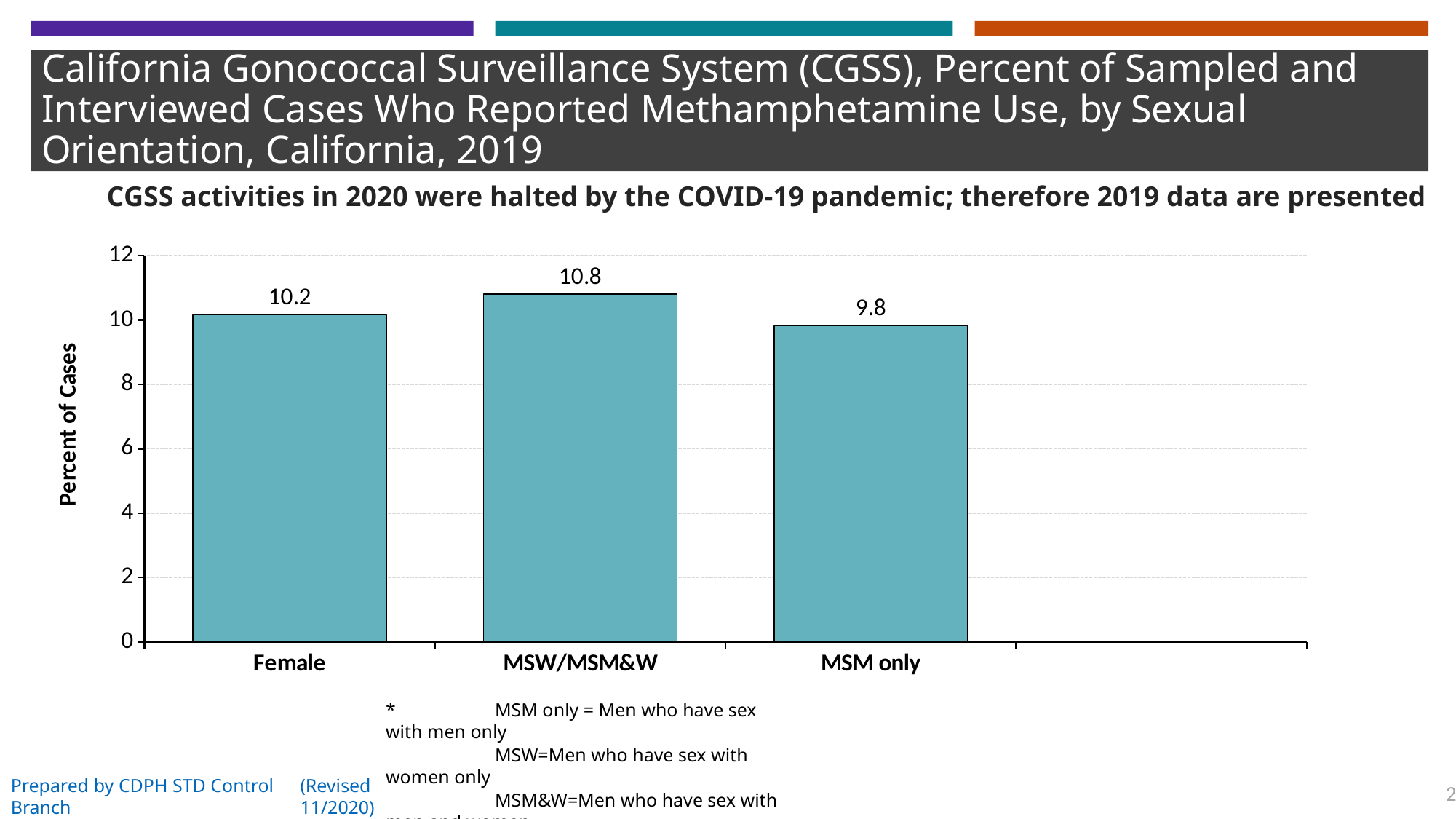
What is the difference between the values for MSW/MSM&W and MSM only? 1.0 What is the percent of cases for Female? 10.2 What is the difference between the values for Female and MSM only? 0.4 Which is larger, the value for Female or the value for MSM only? Female How many categories are shown on the x axis? 3 Is the value for MSM only greater or less than 10? less Which category has the highest percent of cases? MSW/MSM&W Which category has the lowest percent of cases? MSM only What is the percent of cases for MSW/MSM&W? 10.8 What is the percent of cases for MSM only? 9.8 What is the label of the y axis? Percent of Cases What kind of chart is shown on the slide? bar chart